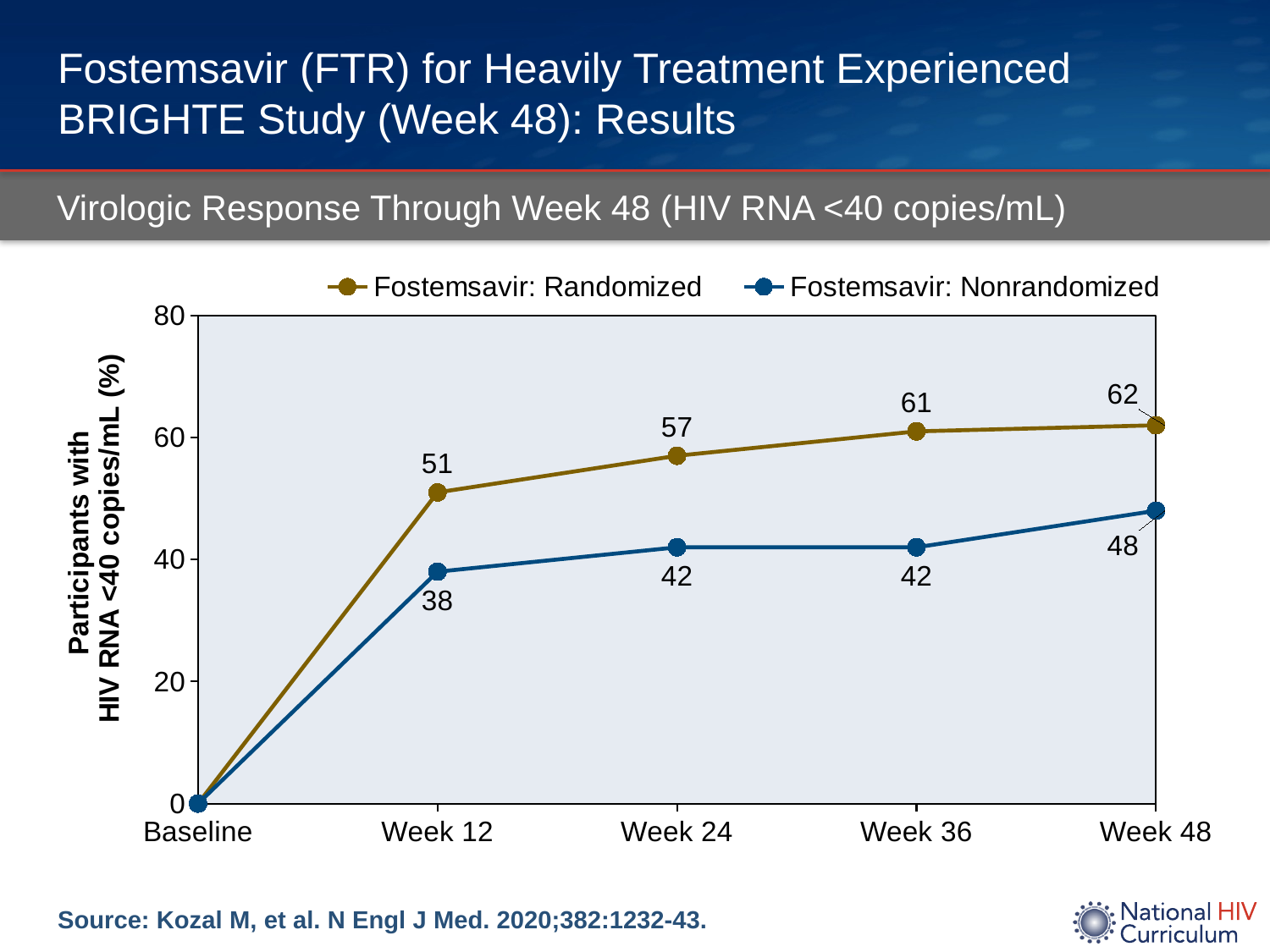
What kind of chart is shown on the slide? Line chart What is the difference between the Fostemsavir: Randomized and Fostemsavir: Nonrandomized values at Week 24? 15 What is the label of the y axis? Participants with HIV RNA <40 copies/mL (%) How many time points are shown on the x axis? 5 How many series does the legend list? 2 What is the value for Fostemsavir: Randomized at Week 12? 51 At which time point does Fostemsavir: Randomized reach its highest value? Week 48 Does the Fostemsavir: Randomized series rise or fall from Baseline to Week 48? Rise Which series has the larger value at Week 36, Fostemsavir: Randomized or Fostemsavir: Nonrandomized? Fostemsavir: Randomized Is the value for Fostemsavir: Nonrandomized at Week 12 greater or less than 40? less What is the value for Fostemsavir: Randomized at Week 36? 61 What is the value for Fostemsavir: Nonrandomized at Week 48? 48